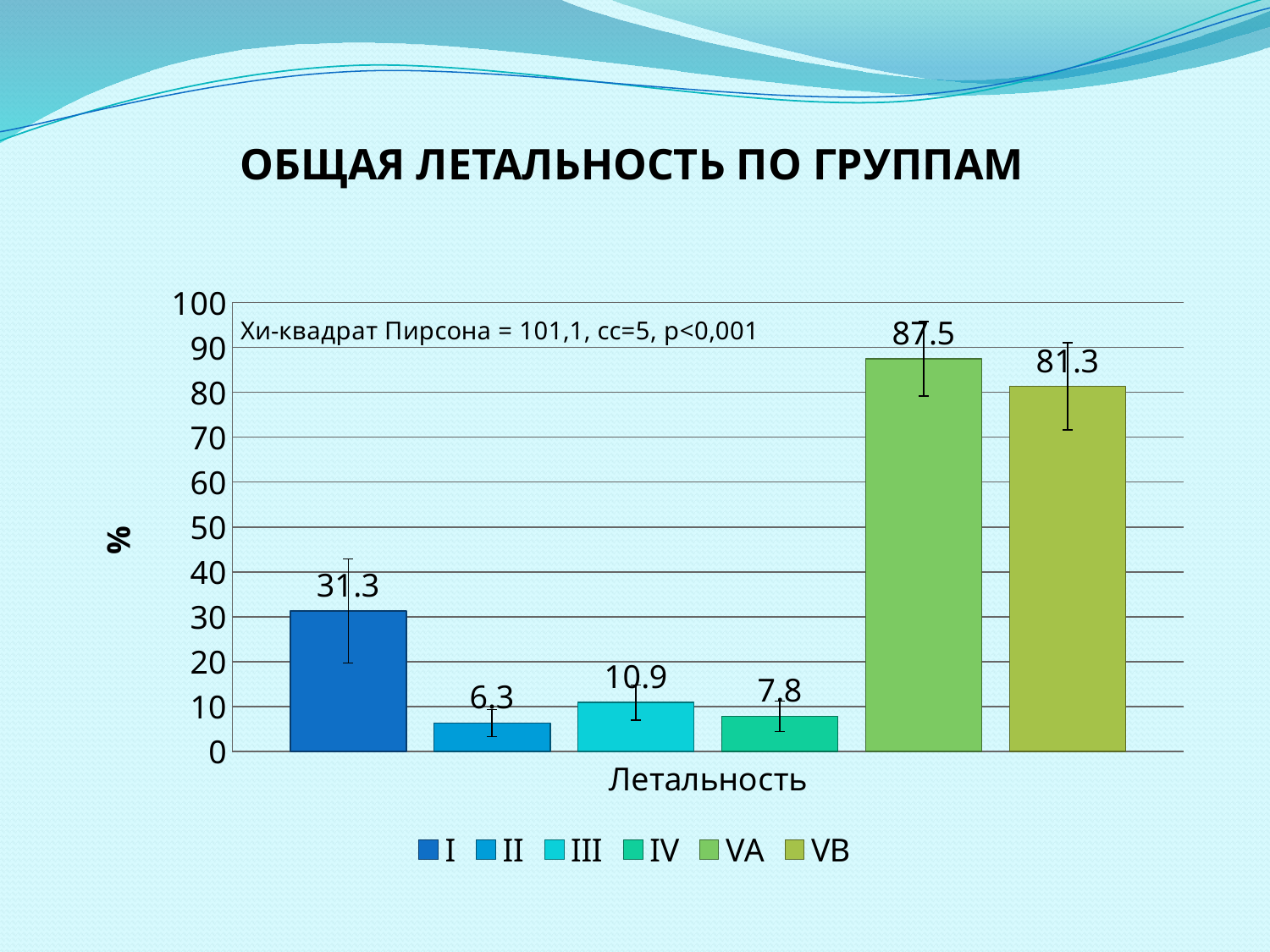
What kind of chart is shown on the slide? bar chart Is the value for group VB greater or less than 70? greater Which group has the highest value? VA What is the difference between the values for I and III? 20.4 What is the title of the chart? ОБЩАЯ ЛЕТАЛЬНОСТЬ ПО ГРУППАМ How many series does the legend list? 6 What is the difference between the values for VA and VB? 6.2 What is the value for group II? 6.3 Which group has the lowest value? II Which is larger, the value for III or the value for IV? III What is the value for group I? 31.3 What is the value for group VA? 87.5